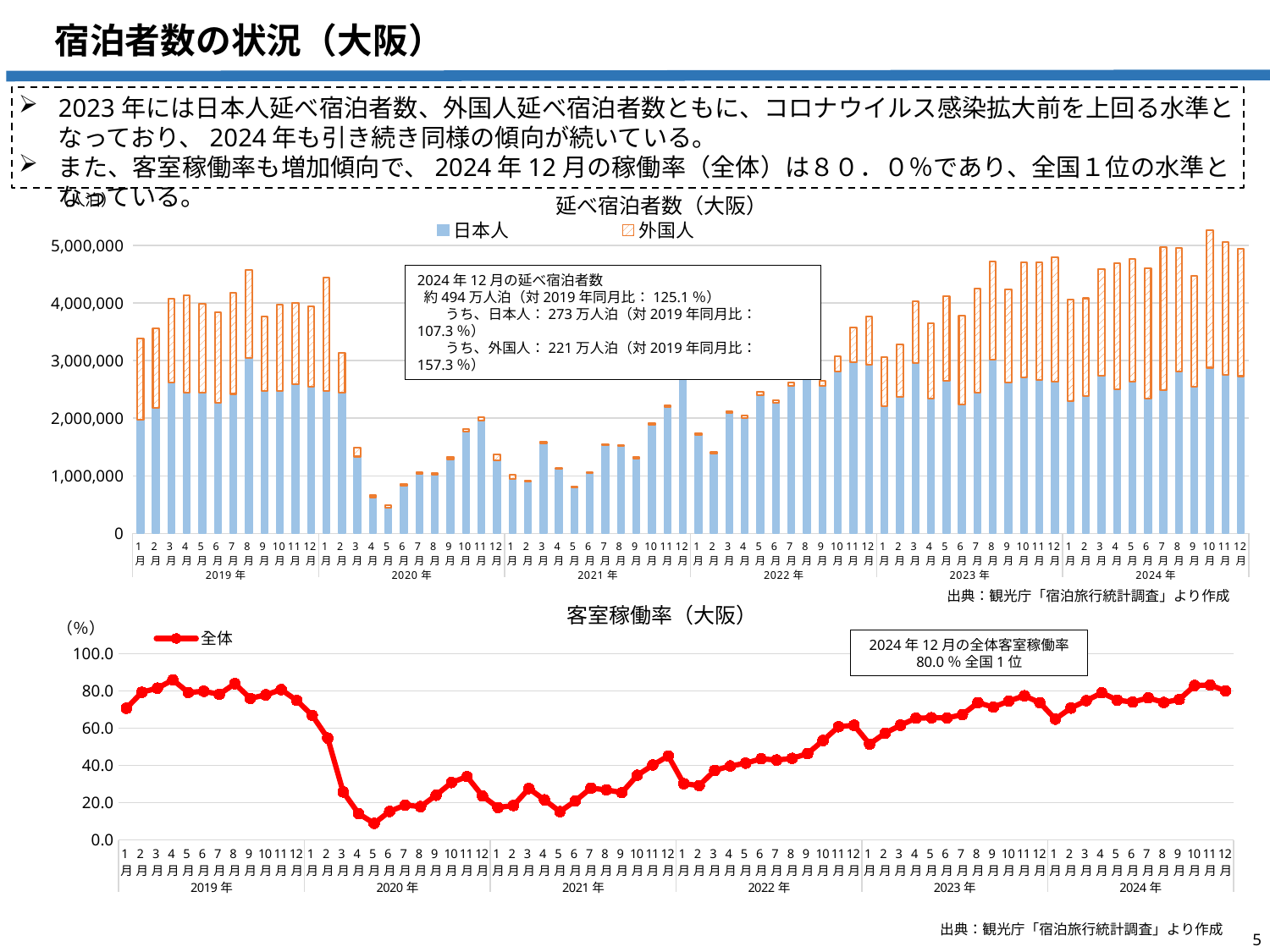
In the bottom chart (客室稼働率（大阪）), is the occupancy rate for 2019年1月 greater or less than 60.0? greater In the top chart, what is the difference between 日本人 and 外国人 overnight stays in 2024年12月? 52万人泊 According to the annotation on the top chart, how many 外国人 overnight stays were there in 2024年12月? 221万人泊 In the top chart, is the total 延べ宿泊者数 for 2020年5月 greater or less than 1,000,000? less In the top chart, which was larger in 2024年12月, 日本人 or 外国人 overnight stays? 日本人 What kind of chart is the top chart titled 延べ宿泊者数（大阪）? Stacked bar chart According to the annotation on the top chart, what was the total 延べ宿泊者数 for 2024年12月? 約494万人泊 In the bottom chart (客室稼働率（大阪）), what was the 全体 occupancy rate in 2024年12月? 80.0% In the top chart (延べ宿泊者数（大阪）), what are the two legend entries? 日本人 and 外国人 According to the annotation on the top chart, how many 日本人 overnight stays were there in 2024年12月? 273万人泊 In the bottom chart (客室稼働率（大阪）), which month has the lowest occupancy rate? 2020年5月 How many series does the legend of the top chart (延べ宿泊者数（大阪）) list? 2